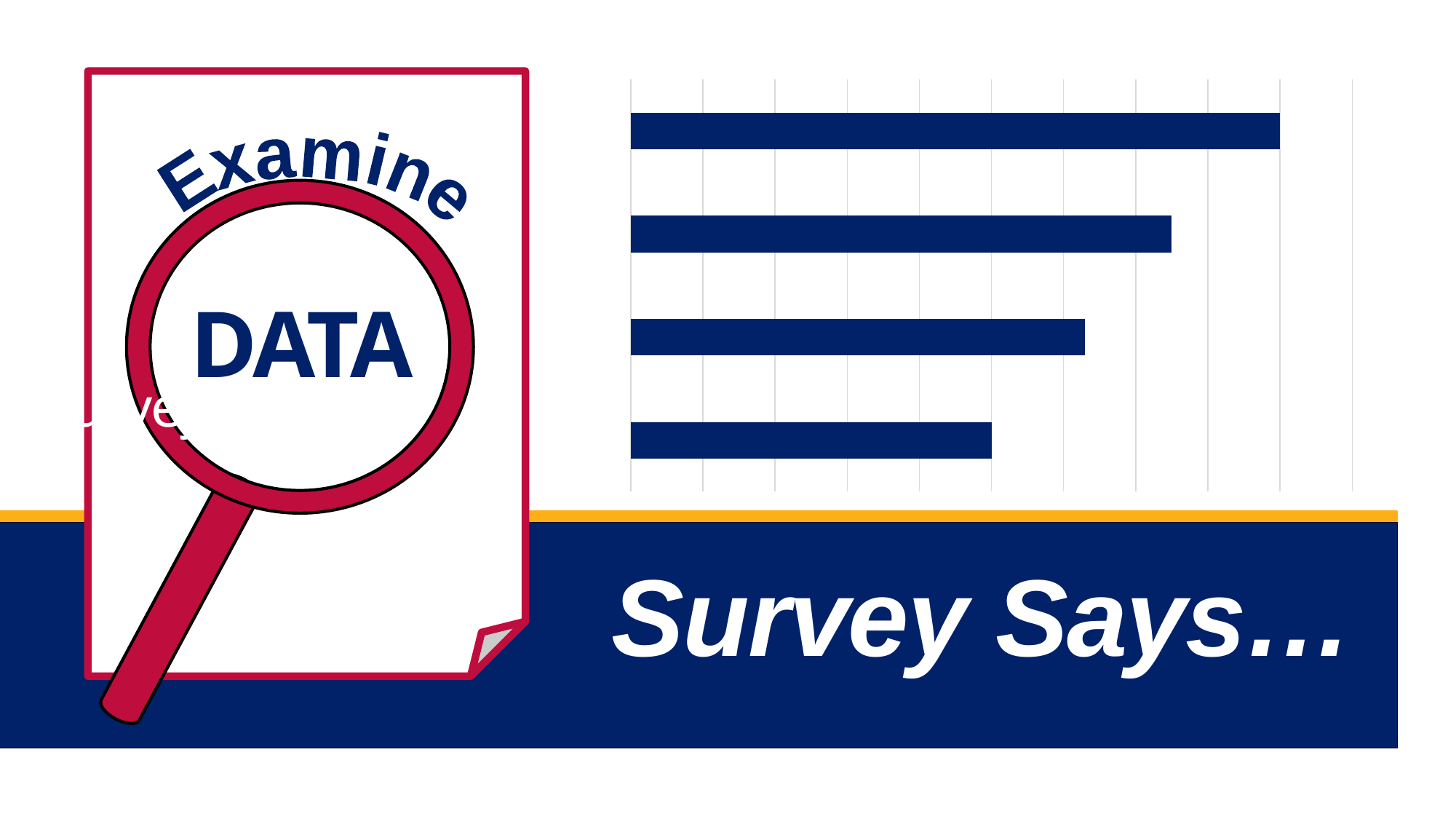
Which bar in the chart is the longest: the top, second, third, or bottom bar? top bar What colour are the bars in the chart? dark blue What kind of chart is shown on the right side of the slide? bar chart How many bars does the chart on the right side of the slide have? 4 Do the bar lengths in the chart increase or decrease going from the top bar to the bottom bar? decrease Are the bars in the chart oriented horizontally or vertically? horizontally Which bar in the chart is the shortest: the top, second, third, or bottom bar? bottom bar Which is longer in the chart, the second bar from the top or the third bar from the top? second bar from the top Which is longer in the chart, the third bar from the top or the bottom bar? third bar from the top